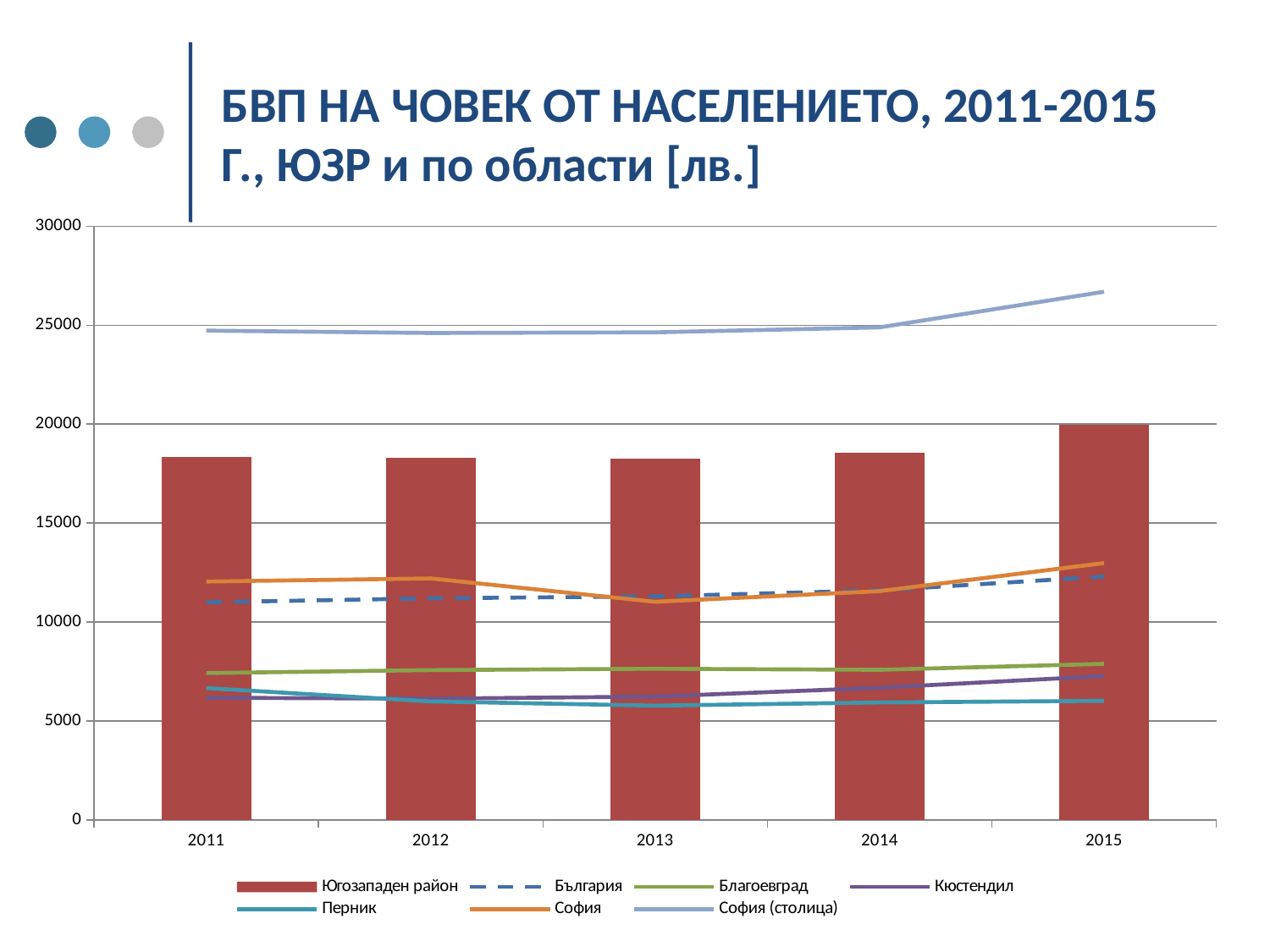
Is the value for София (столица) in 2015 greater or less than 25000? greater Is the value for Югозападен район in 2011 greater or less than 20000? less Which series is shown as bars rather than a line? Югозападен район What kind of chart is shown on the slide? A combination chart with bars and lines Does the value for София (столица) rise or fall from 2014 to 2015? rise How many years are shown on the x axis? 5 How many series does the legend list? 7 Is the value for Благоевград in 2015 greater or less than 10000? less Which series has the lowest value in 2015? Перник In 2011, which is larger: the value for София or the value for България? София Which series has the highest value in 2015? София (столица) Which series is drawn as a dashed line? България